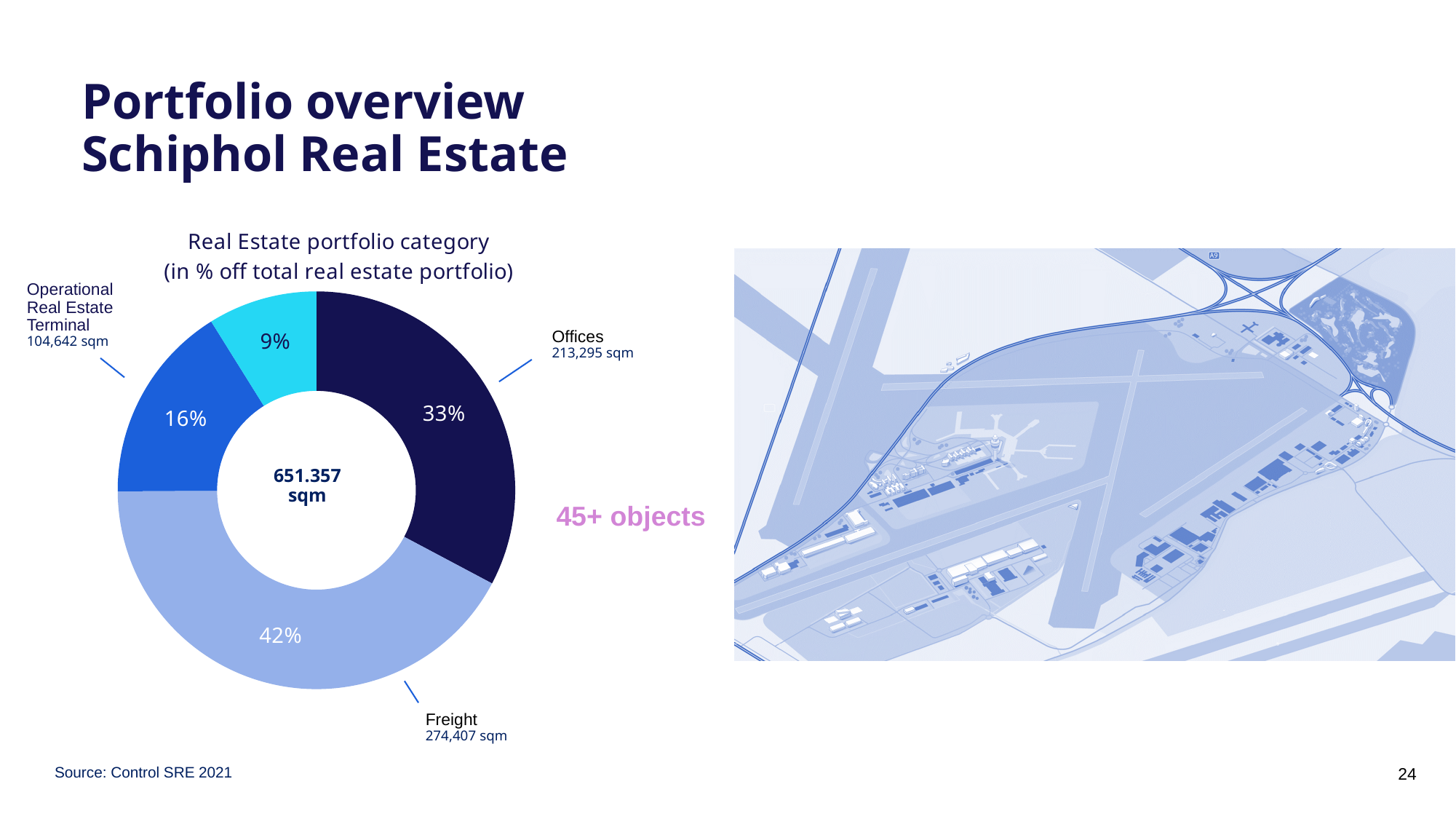
How many slices does the chart have? 4 What is the smallest percentage shown on the chart? 9% Which category has the largest share of the real estate portfolio? Freight What kind of chart is shown on the slide? Pie chart (donut) What percentage of the real estate portfolio is Operational Real Estate Terminal? 16% What is the title of the chart? Real Estate portfolio category (in % off total real estate portfolio) What percentage of the real estate portfolio is Freight? 42% What is the area in sqm of the Freight category? 274,407 sqm What is the area in sqm of the Offices category? 213,295 sqm What percentage of the real estate portfolio is Offices? 33% What is the area in sqm of the Operational Real Estate Terminal category? 104,642 sqm What total area is shown in the centre of the chart? 651.357 sqm